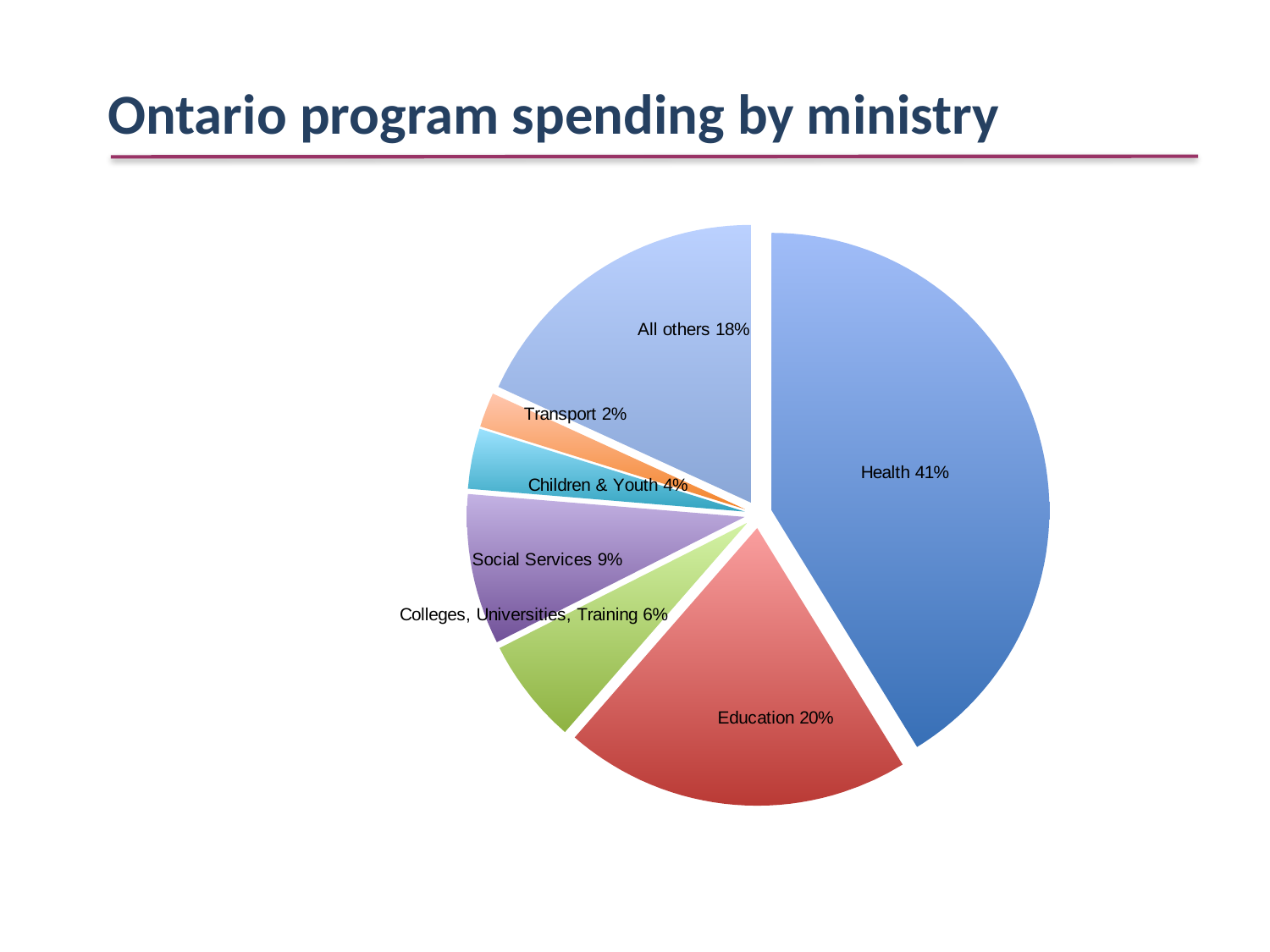
Which ministry has the smallest share of Ontario program spending? Transport What kind of chart is shown on the slide? Pie chart Which has a larger share of spending, Social Services or Children & Youth? Social Services How many slices does the pie chart have? 7 What is the title of the slide? Ontario program spending by ministry Which ministry has the largest share of Ontario program spending? Health What share of Ontario program spending goes to Health? 41% What is the combined share of Education and Colleges, Universities, Training? 26% What is the difference in percentage points between the Health share and the Education share? 21 What share of Ontario program spending goes to Education? 20% What share of Ontario program spending goes to Transport? 2% What share of Ontario program spending goes to Social Services? 9%